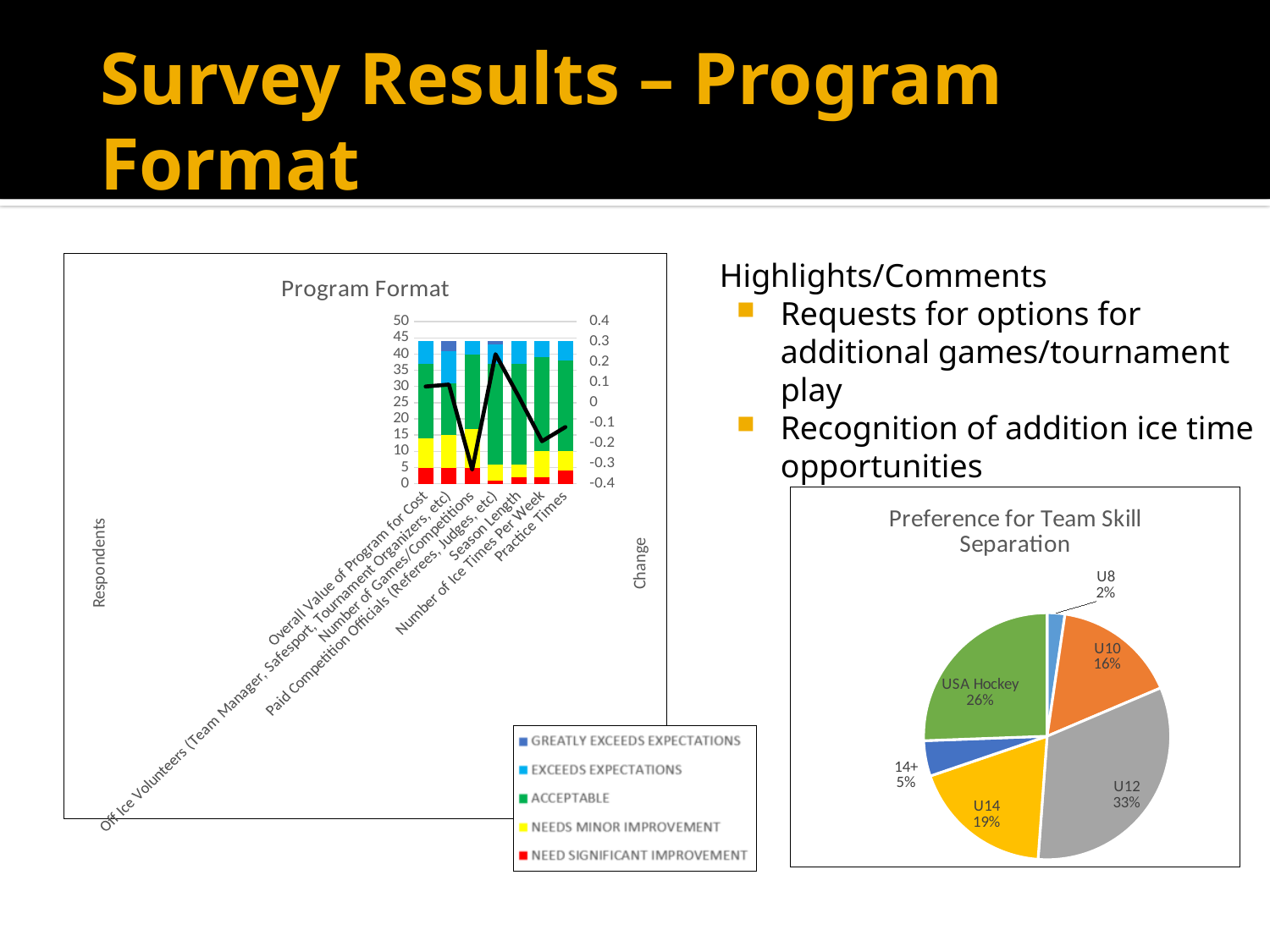
How many categories are shown on the x axis of the Program Format chart? 7 What kind of chart is the Preference for Team Skill Separation chart? Pie chart In the Preference for Team Skill Separation pie chart, which category has the smallest slice? U8 How many slices does the Preference for Team Skill Separation pie chart have? 6 In the Preference for Team Skill Separation pie chart, which is larger, U14 or U10? U14 In the Preference for Team Skill Separation pie chart, how many percentage points larger is U12 than U10? 17 How many series does the legend of the Program Format chart list? 5 In the Preference for Team Skill Separation pie chart, what share does U12 have? 33% In the Preference for Team Skill Separation pie chart, what share does USA Hockey have? 26% In the Preference for Team Skill Separation pie chart, what share does 14+ have? 5% In the Program Format chart, what is the title of the left vertical axis? Respondents In the Preference for Team Skill Separation pie chart, which category has the largest slice? U12